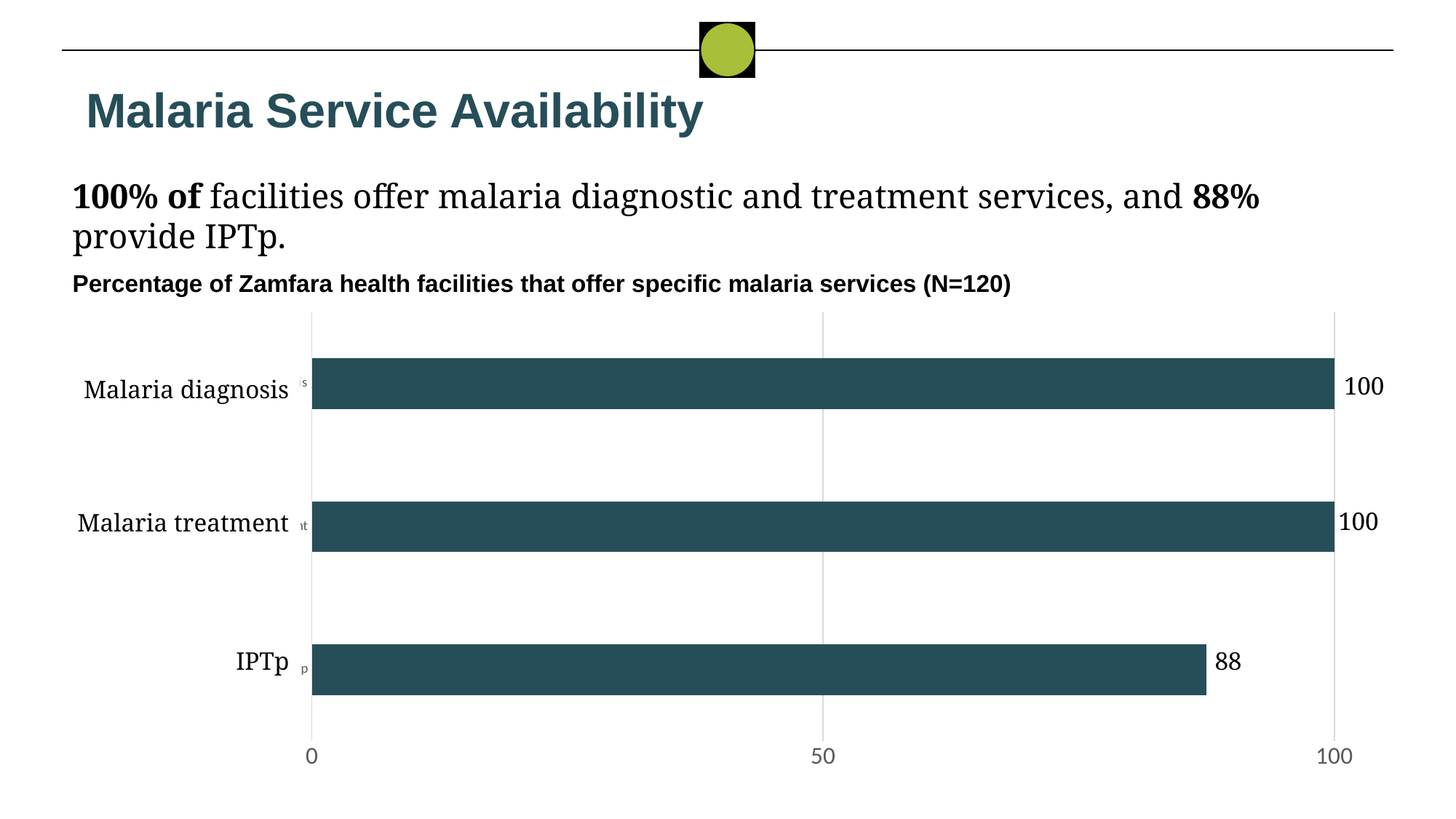
What kind of chart is shown on the slide? bar chart What is the title of the chart? Percentage of Zamfara health facilities that offer specific malaria services (N=120) How many categories have a value of 100? 2 How many categories are shown in the chart? 3 Which category has the lowest value? IPTp What is the difference between the value for Malaria diagnosis and the value for IPTp? 12 What is the value for Malaria diagnosis? 100 What is the highest value shown on the x axis? 100 Which is larger, the value for Malaria treatment or the value for IPTp? Malaria treatment What is the value for Malaria treatment? 100 What is the value for IPTp? 88 Is the value for IPTp greater or less than 50? greater